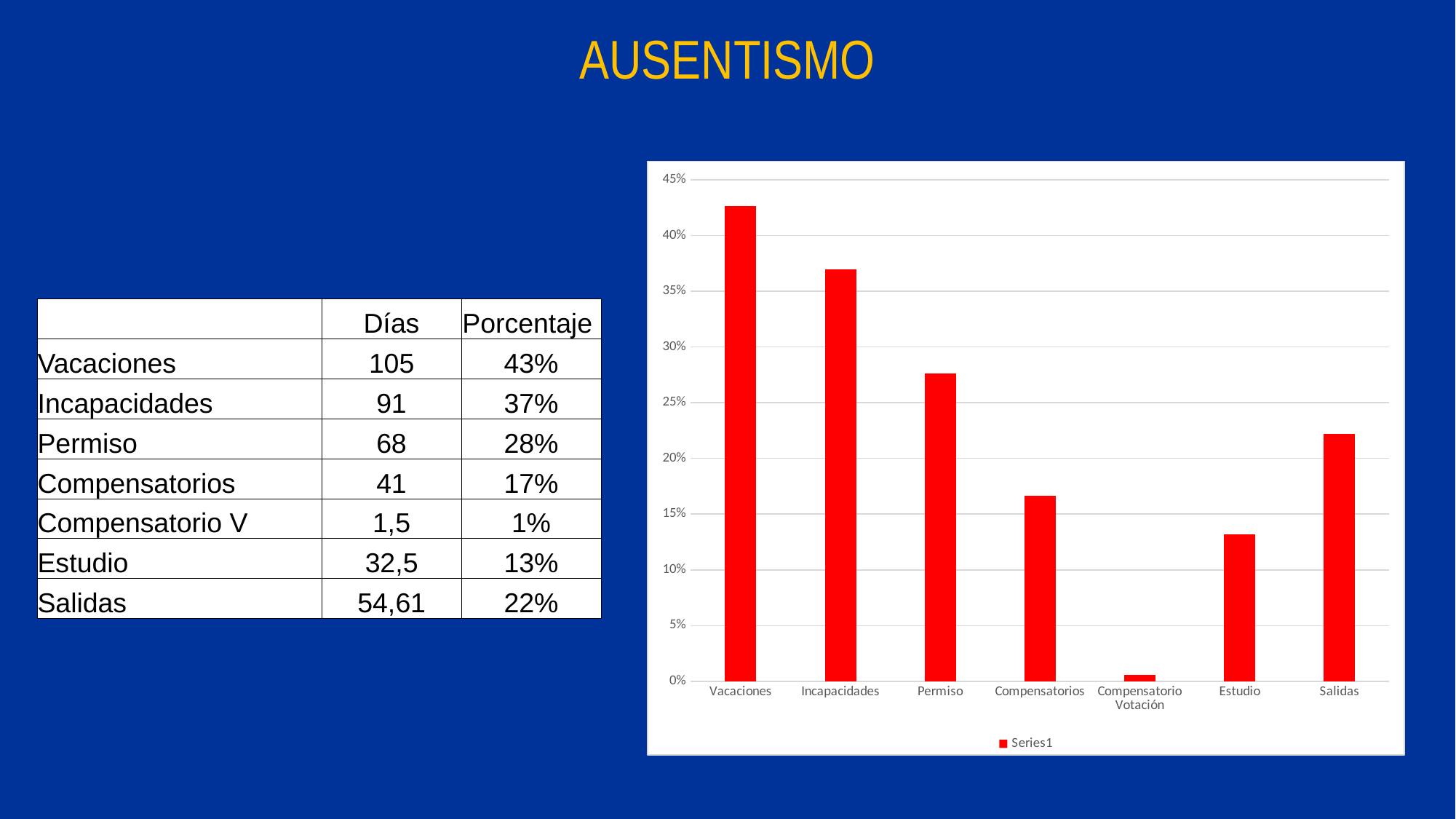
What is the name of the series shown in the chart legend? Series1 Is the value for Incapacidades greater or less than 35%? greater Which is larger, the value for Permiso or the value for Compensatorios? Permiso Is the value for Vacaciones greater or less than 40%? greater Which category has the lowest bar in the chart? Compensatorio Votación How many series does the chart legend list? 1 What kind of chart is shown on the slide? Bar chart Is the value for Compensatorio Votación greater or less than 5%? less Which category has the highest bar in the chart? Vacaciones How many categories are shown on the x axis of the chart? 7 Which is larger, the value for Salidas or the value for Estudio? Salidas